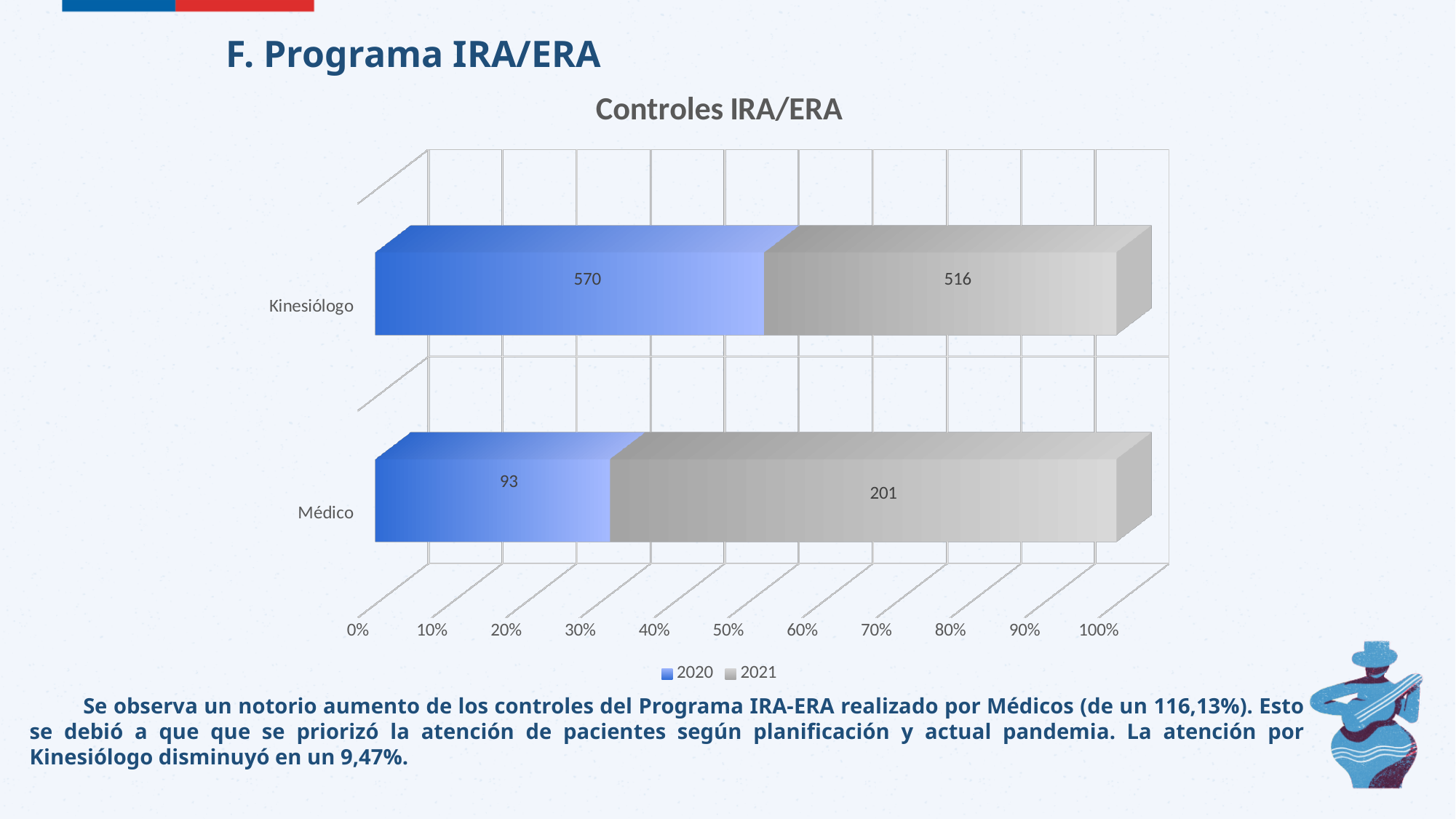
What is the difference between the 2020 and 2021 values for Kinesiólogo? 54 For Médico, which series has the larger value, 2020 or 2021? 2021 What is the difference between the 2020 and 2021 values for Médico? 108 What is the value for Kinesiólogo in the 2020 series? 570 What kind of chart is shown on the slide? Bar chart What is the value for Kinesiólogo in the 2021 series? 516 Which category has the lowest value in the 2020 series? Médico Which category has the highest value in the 2021 series? Kinesiólogo How many categories are shown on the chart? 2 What is the value for Médico in the 2020 series? 93 How many series does the legend list? 2 What is the value for Médico in the 2021 series? 201